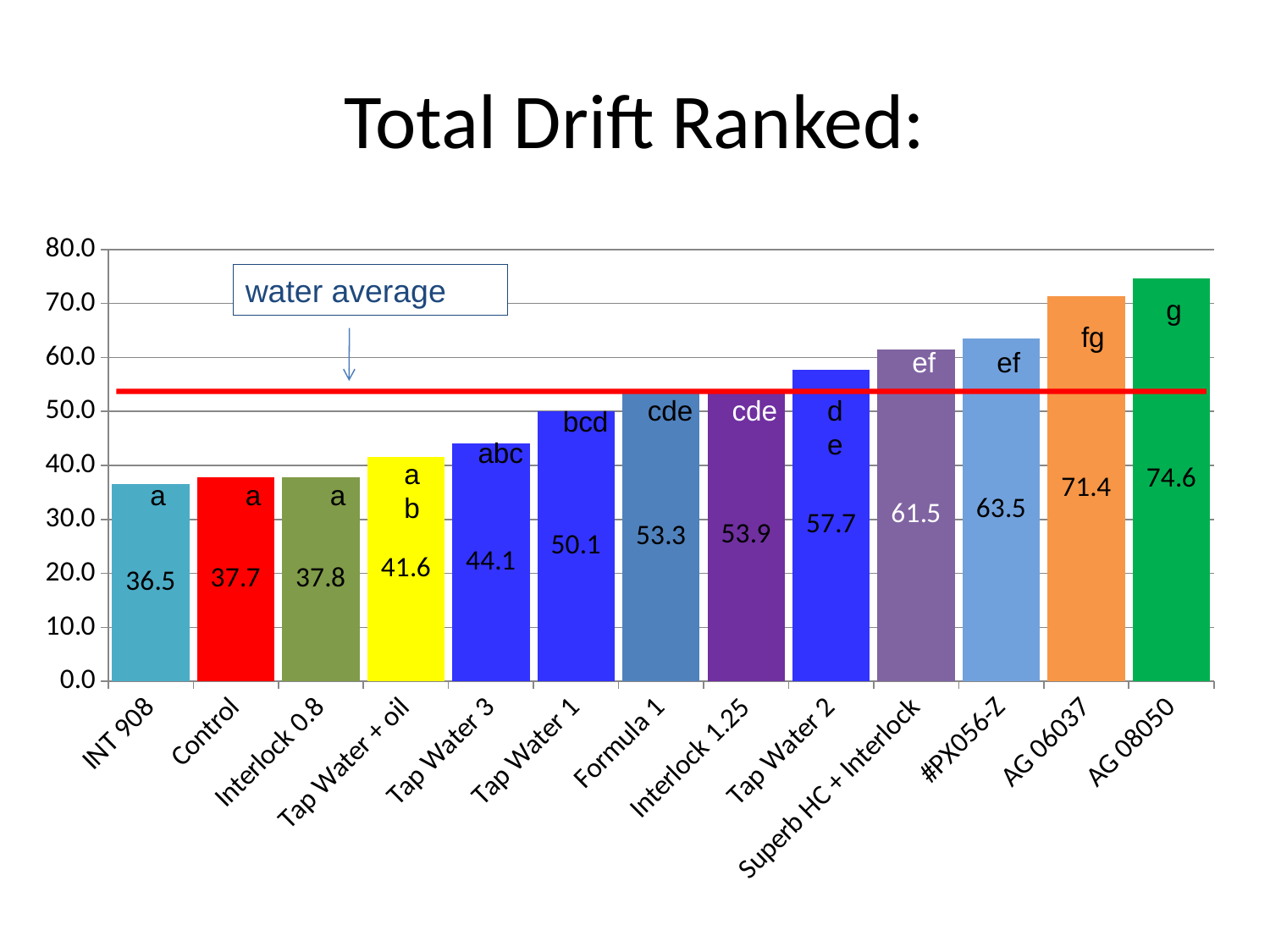
Which category has the highest value? AG 08050 Which is larger, the value for Formula 1 or the value for Tap Water + oil? Formula 1 What is the value for Superb HC + Interlock? 61.5 What does the red horizontal line on the chart represent? water average What kind of chart is shown on the slide? bar chart How many categories are shown on the x axis? 13 What is the difference between the values for AG 08050 and INT 908? 38.1 What is the value for Tap Water 3? 44.1 What is the difference between the values for Tap Water 2 and Tap Water 1? 7.6 What is the value for AG 06037? 71.4 Is the value for #PX056-Z greater or less than 60.0? greater Which category has the lowest value? INT 908